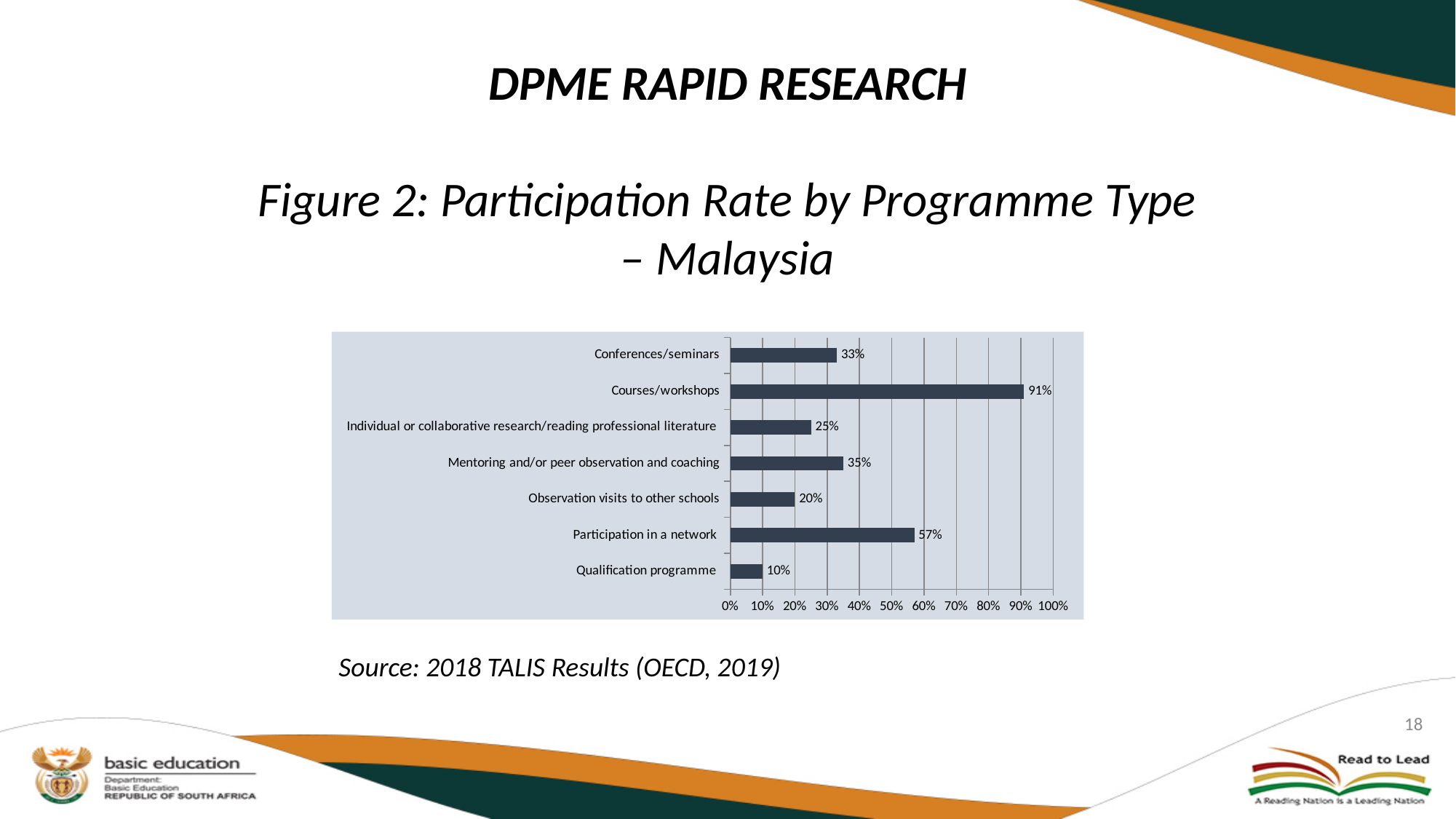
What is the difference in participation rate between Mentoring and/or peer observation and coaching and Conferences/seminars? 2% Which programme type has the highest participation rate? Courses/workshops Which has a higher participation rate: Conferences/seminars or Individual or collaborative research/reading professional literature? Conferences/seminars Which programme type has the lowest participation rate? Qualification programme What is the participation rate for Participation in a network? 57% What is the participation rate for Courses/workshops? 91% How many programme types are shown in the chart? 7 What is the participation rate for Qualification programme? 10% What kind of chart is shown on the slide? Bar chart Is the participation rate for Participation in a network greater or less than 50%? greater What is the participation rate for Observation visits to other schools? 20% What is the difference in participation rate between Courses/workshops and Participation in a network? 34%